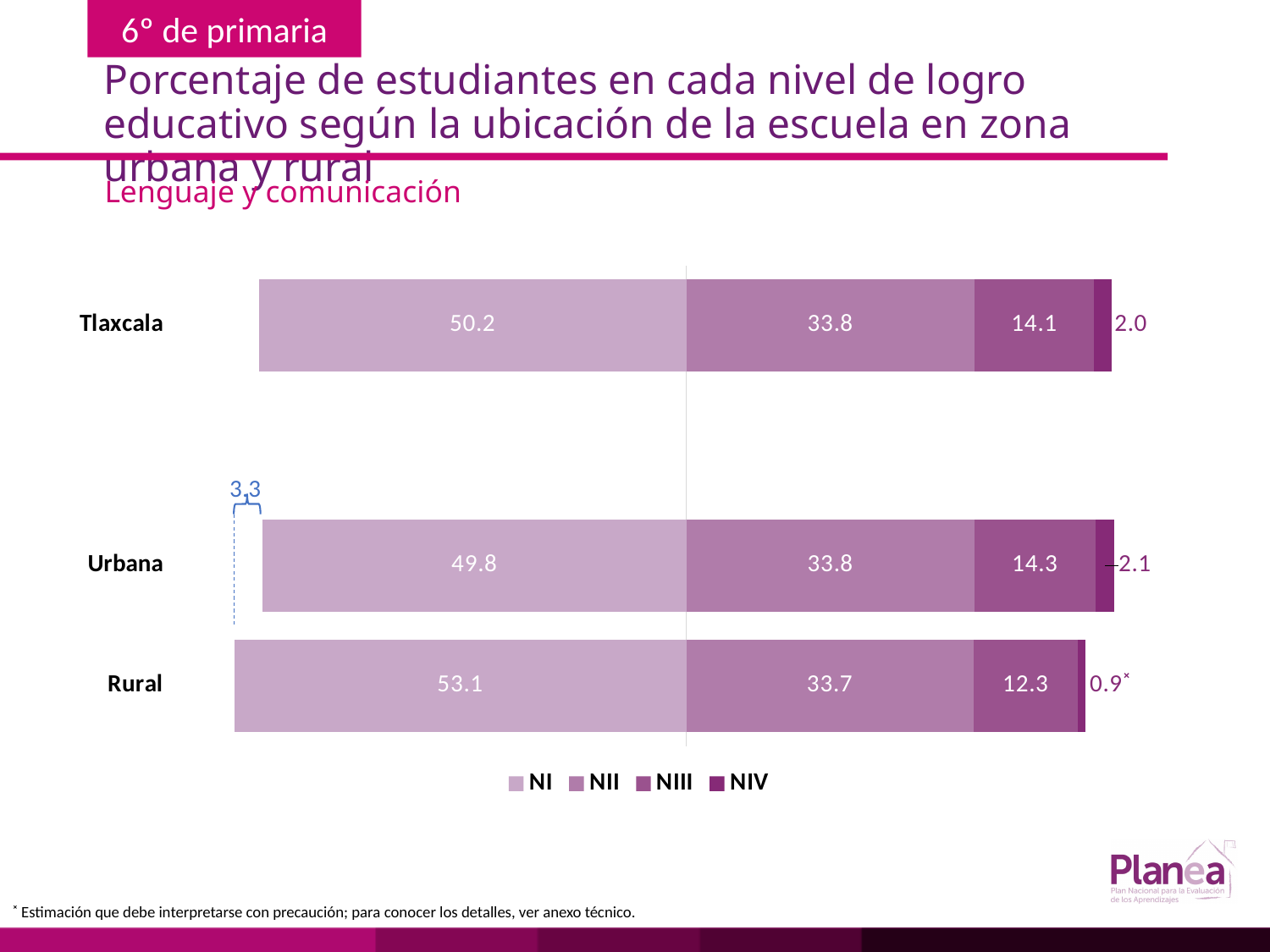
What is the NII value for Rural? 33.7 How many categories are shown on the chart? 3 What kind of chart is shown on the slide? Stacked bar chart Which is larger, the NIII value for Tlaxcala or for Rural? Tlaxcala What is the NIII value for Urbana? 14.3 How many series does the legend list? 4 Which value on the chart is marked with an asterisk as an estimate to be interpreted with caution? 0.9 (Rural, NIV) What is the difference between the NI values for Rural and Urbana? 3.3 Which category has the highest NI value? Rural What is the NIV value for Tlaxcala? 2.0 What percentage of Rural students are at level NI? 53.1 Which category has the lowest NIV value? Rural